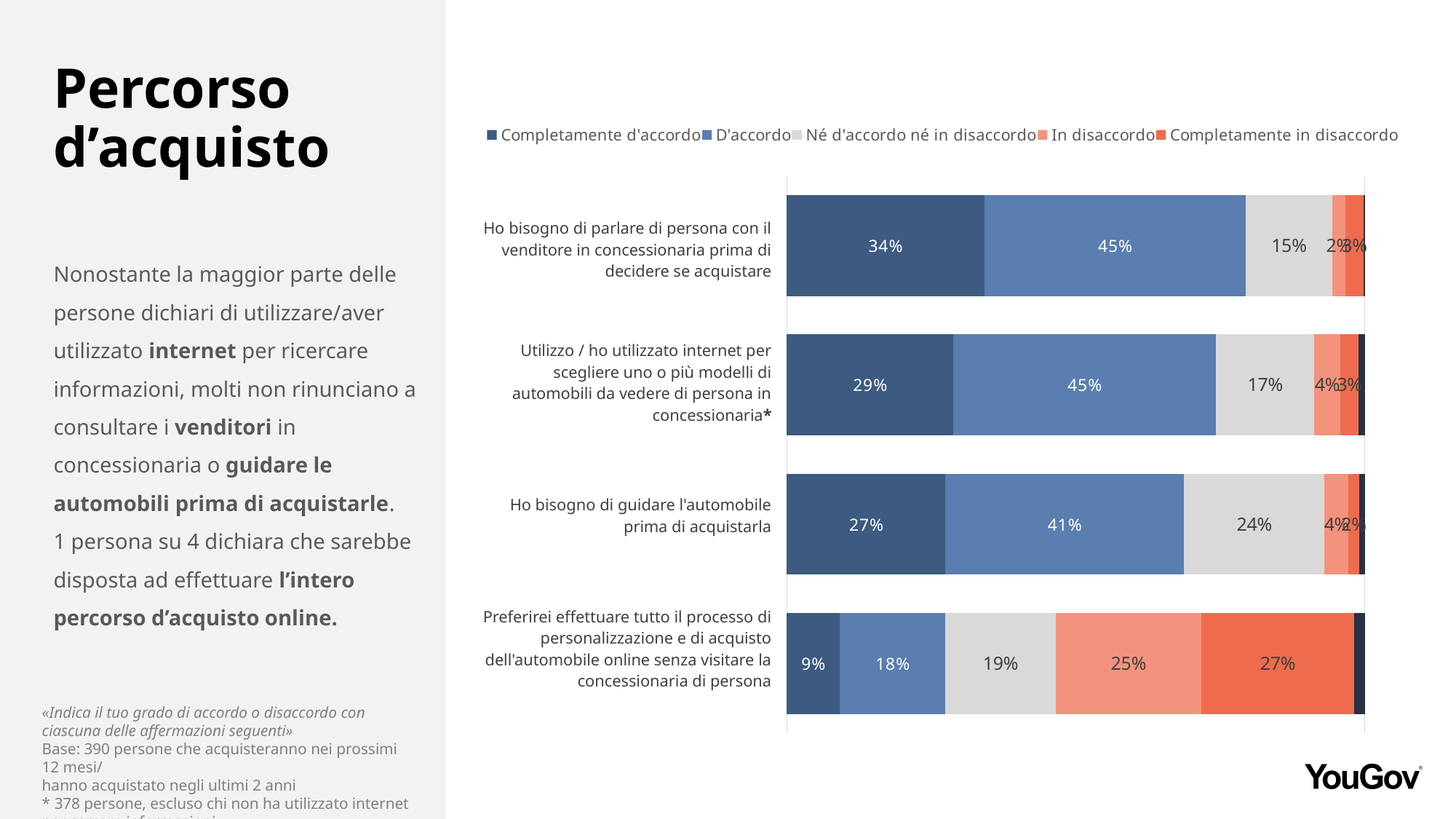
What is the 'Completamente d'accordo' value for 'Ho bisogno di parlare di persona con il venditore in concessionaria prima di decidere se acquistare'? 34% For 'Preferirei effettuare tutto il processo di personalizzazione e di acquisto dell'automobile online senza visitare la concessionaria di persona', which is larger: 'In disaccordo' or 'Né d'accordo né in disaccordo'? In disaccordo How many series does the legend list? 5 What is the 'Completamente in disaccordo' value for 'Preferirei effettuare tutto il processo di personalizzazione e di acquisto dell'automobile online senza visitare la concessionaria di persona'? 27% What is the difference between the 'Né d'accordo né in disaccordo' values for 'Ho bisogno di guidare l'automobile prima di acquistarla' and 'Ho bisogno di parlare di persona con il venditore in concessionaria prima di decidere se acquistare'? 9% What is the 'Né d'accordo né in disaccordo' value for 'Utilizzo / ho utilizzato internet per scegliere uno o più modelli di automobili da vedere di persona in concessionaria'? 17% What kind of chart is shown on the slide? stacked bar chart Which legend entry is shown in the lightest grey colour? Né d'accordo né in disaccordo How many statements (categories) are plotted in the chart? 4 What is the 'D'accordo' value for 'Ho bisogno di guidare l'automobile prima di acquistarla'? 41% Which statement has the lowest 'D'accordo' value? Preferirei effettuare tutto il processo di personalizzazione e di acquisto dell'automobile online senza visitare la concessionaria di persona Which statement has the highest 'Completamente d'accordo' value? Ho bisogno di parlare di persona con il venditore in concessionaria prima di decidere se acquistare